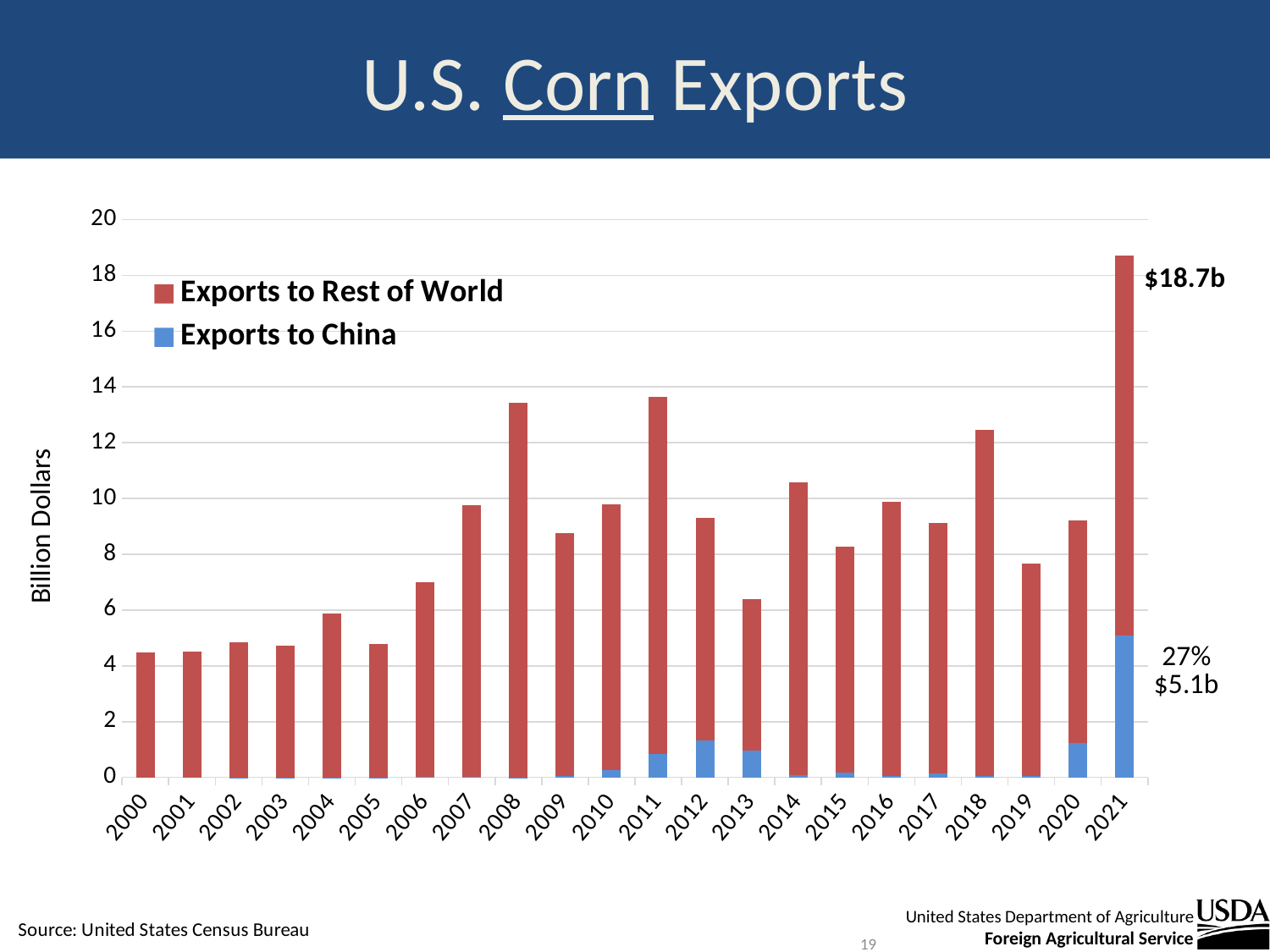
Is the total value for 2008 greater or less than 12 billion dollars? greater How many years are shown on the x axis? 22 What is the label on the y axis? Billion Dollars What kind of chart is shown on the slide? Stacked bar chart Which year has the highest total corn exports? 2021 How many series does the legend list? 2 What share of 2021 U.S. corn exports went to China, according to the label on the chart? 27% Using the labeled values, how much of the 2021 total went to the rest of the world ($18.7b total minus $5.1b to China)? $13.6b Is the total value for 2013 greater or less than 8 billion dollars? less What is the value of exports to China in 2021 as labeled on the chart? $5.1b Which year has the larger total corn exports, 2011 or 2014? 2011 What is the total value of U.S. corn exports in 2021 as labeled on the chart? $18.7b